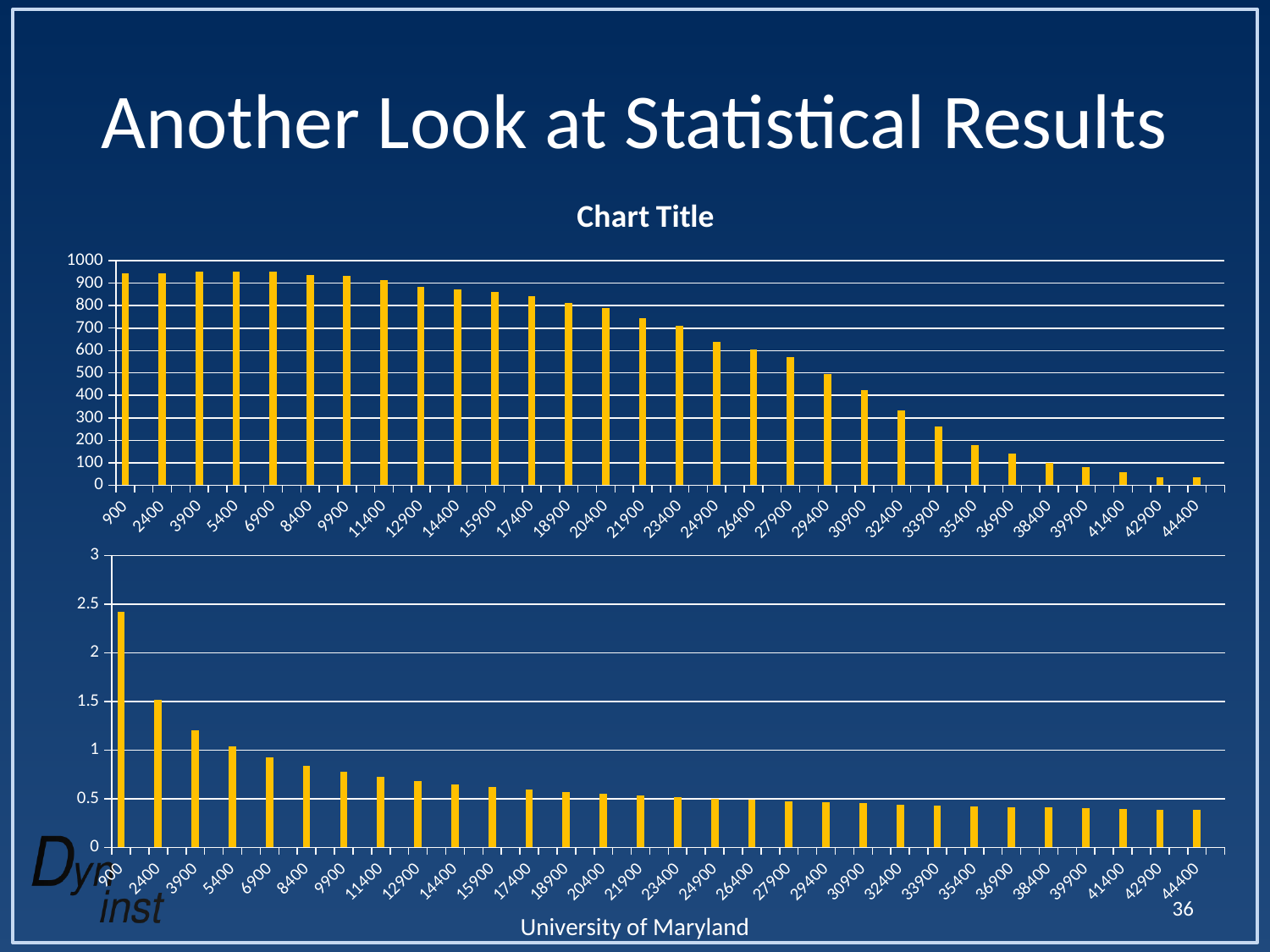
In the top chart, do the values rise or fall as you move from left to right along the x axis? fall What is the title shown above the top chart? Chart Title In the bottom chart, is the value for 6900 greater or less than 1? less In the top chart, which is larger, the value for 20400 or the value for 30900? 20400 In the bottom chart, which category has the highest value? 900 In the top chart, is the value for 33900 greater or less than 300? less In the bottom chart, do the values rise or fall as you move from left to right along the x axis? fall In the top chart, is the value for 20400 greater or less than 700? greater What type of chart is the top chart on the slide? bar chart How many categories are shown on the x axis of the top chart? 30